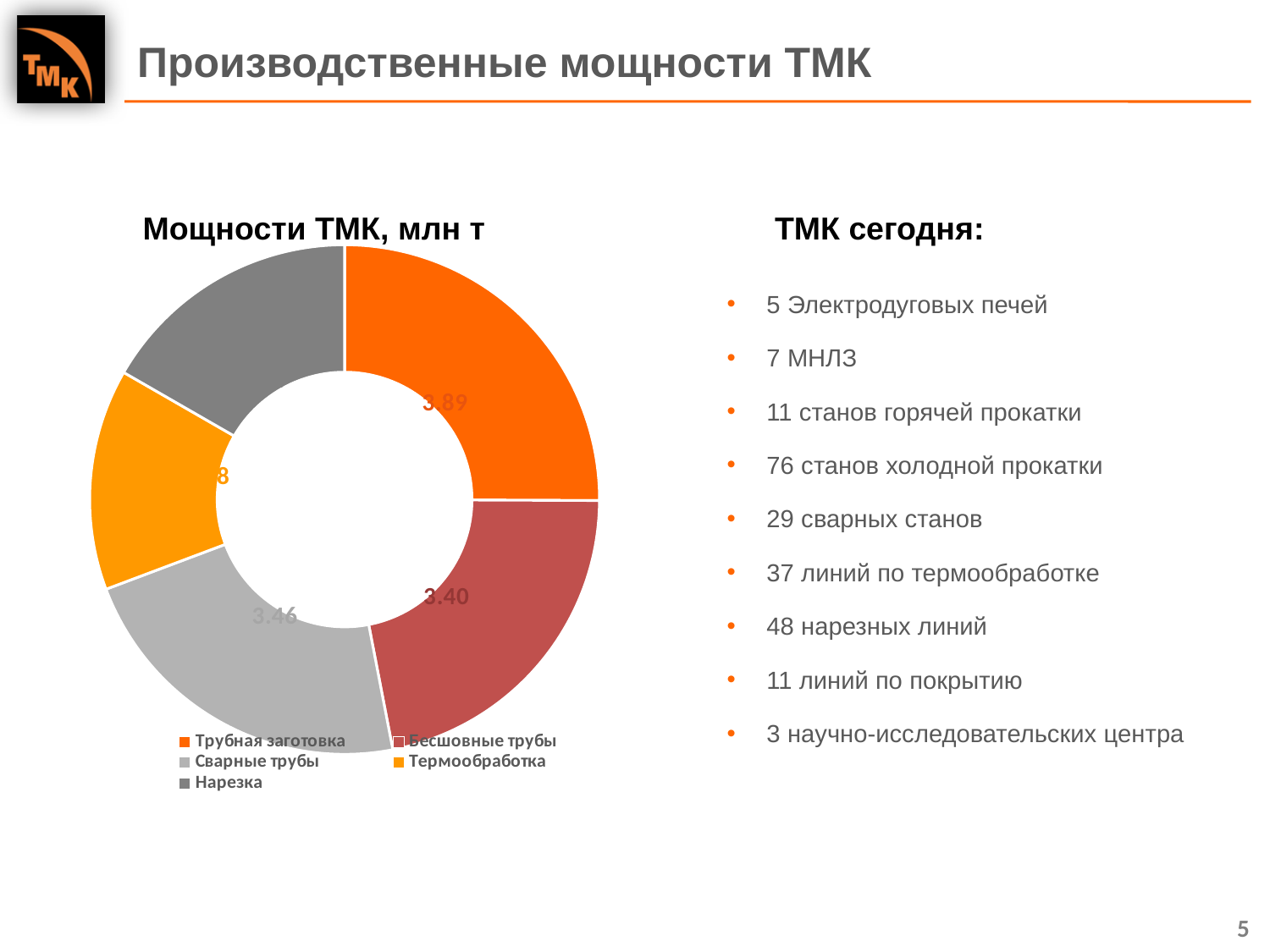
How many categories does the chart's legend list? 5 What is the value for Бесшовные трубы? 3.40 What is the value for Сварные трубы? 3.46 Which category has the smallest segment in the chart? Термообработка What is the difference between the values for Трубная заготовка and Бесшовные трубы? 0.49 What kind of chart is shown on the slide? doughnut chart Which is larger, the value for Трубная заготовка or the value for Бесшовные трубы? Трубная заготовка What is the value for Трубная заготовка? 3.89 What is the title of the chart? Мощности ТМК, млн т What is the difference between the values for Трубная заготовка and Сварные трубы? 0.43 What colour is the segment for Трубная заготовка? orange Which category has the largest segment in the chart? Трубная заготовка